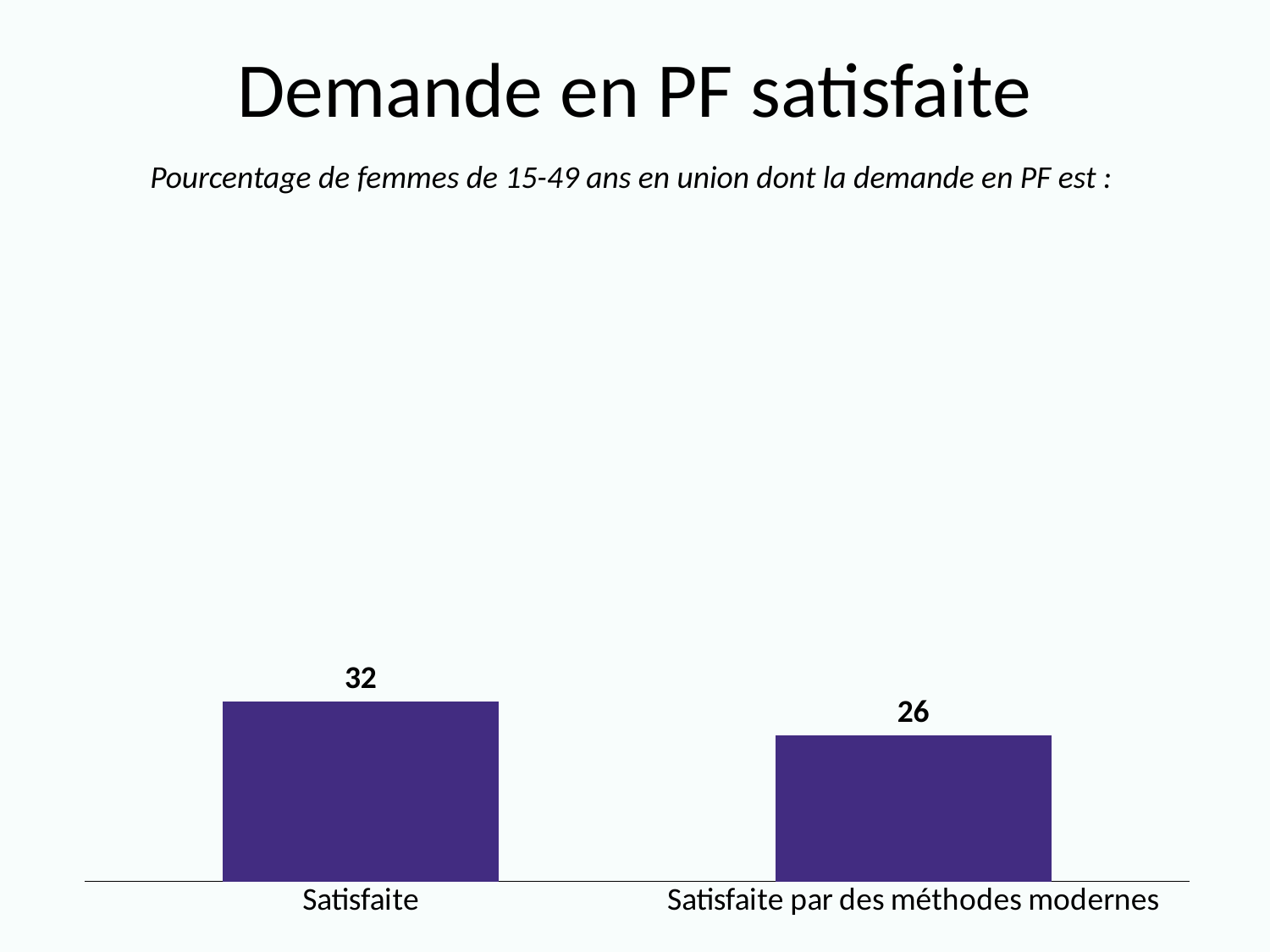
How many categories are shown in the chart? 2 What is the value for Satisfaite? 32 What is the value for Satisfaite par des méthodes modernes? 26 Which category has the lowest value? Satisfaite par des méthodes modernes What colour are the bars in the chart? Purple Do the values rise or fall from left to right across the categories? Fall Which category has the highest value? Satisfaite What is the title of the slide containing the chart? Demande en PF satisfaite What kind of chart is shown on the slide? Bar chart Which is larger, the value for Satisfaite or the value for Satisfaite par des méthodes modernes? Satisfaite What is the difference between the values for Satisfaite and Satisfaite par des méthodes modernes? 6